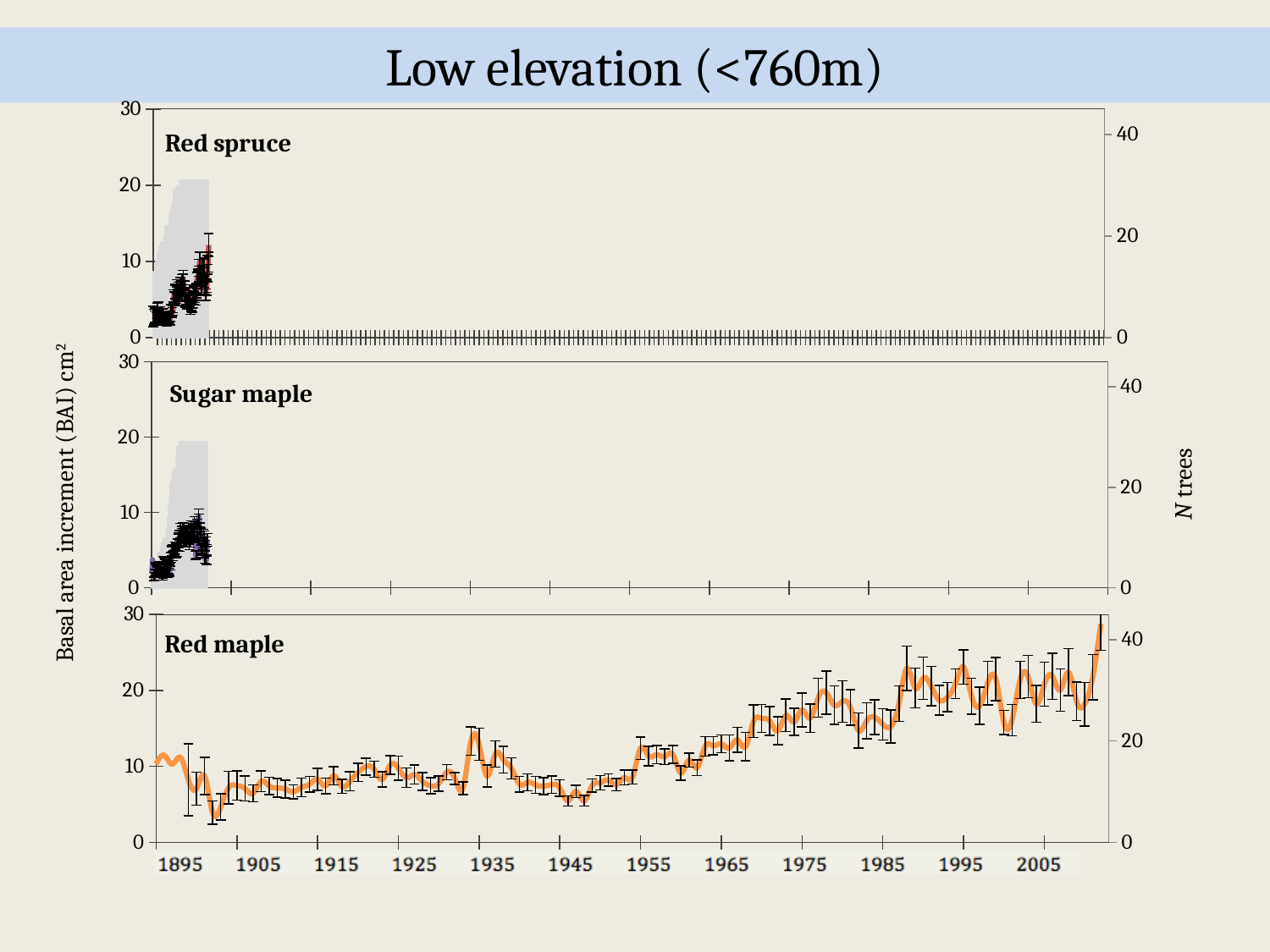
In the Red maple panel, is the value around 1975 greater or less than 10? greater What is the label of the left y-axis? Basal area increment (BAI) cm² What kind of chart is the Red maple panel? line chart In the Red maple panel, is the value around 1915 greater or less than 20? less In the Red maple panel, which is larger, the value around 1995 or the value around 1945? 1995 How many species panels are shown on the slide? 3 In the Red maple panel, is the value around 1945 greater or less than 10? less Which species panel is at the bottom of the slide? Red maple In the Red maple panel, does the basal area increment generally rise or fall from 1945 to 2005? rise What is the title of the slide? Low elevation (<760m)